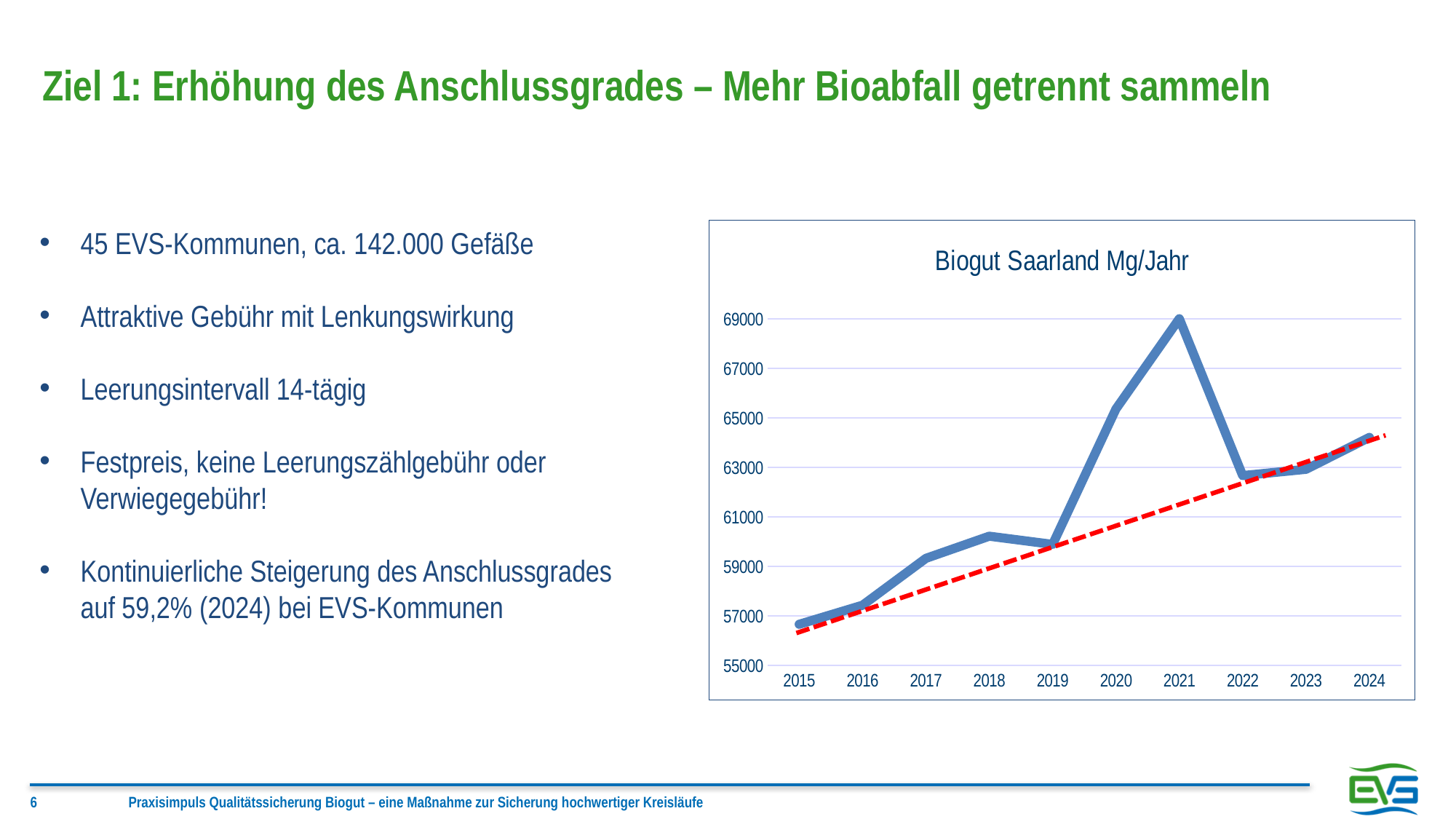
Which year has the larger value, 2016 or 2017? 2017 What is the title of the chart? Biogut Saarland Mg/Jahr In which year does the chart reach its highest value? 2021 How many years are plotted on the x axis of the chart? 10 Is the value for 2021 greater or less than 67000? greater Is the value for 2018 greater or less than 59000? greater Which year has the larger value, 2020 or 2022? 2020 What kind of chart is shown on the slide? line chart Does the red dashed trend line rise or fall from 2015 to 2024? rise In which year does the chart show its lowest value? 2015